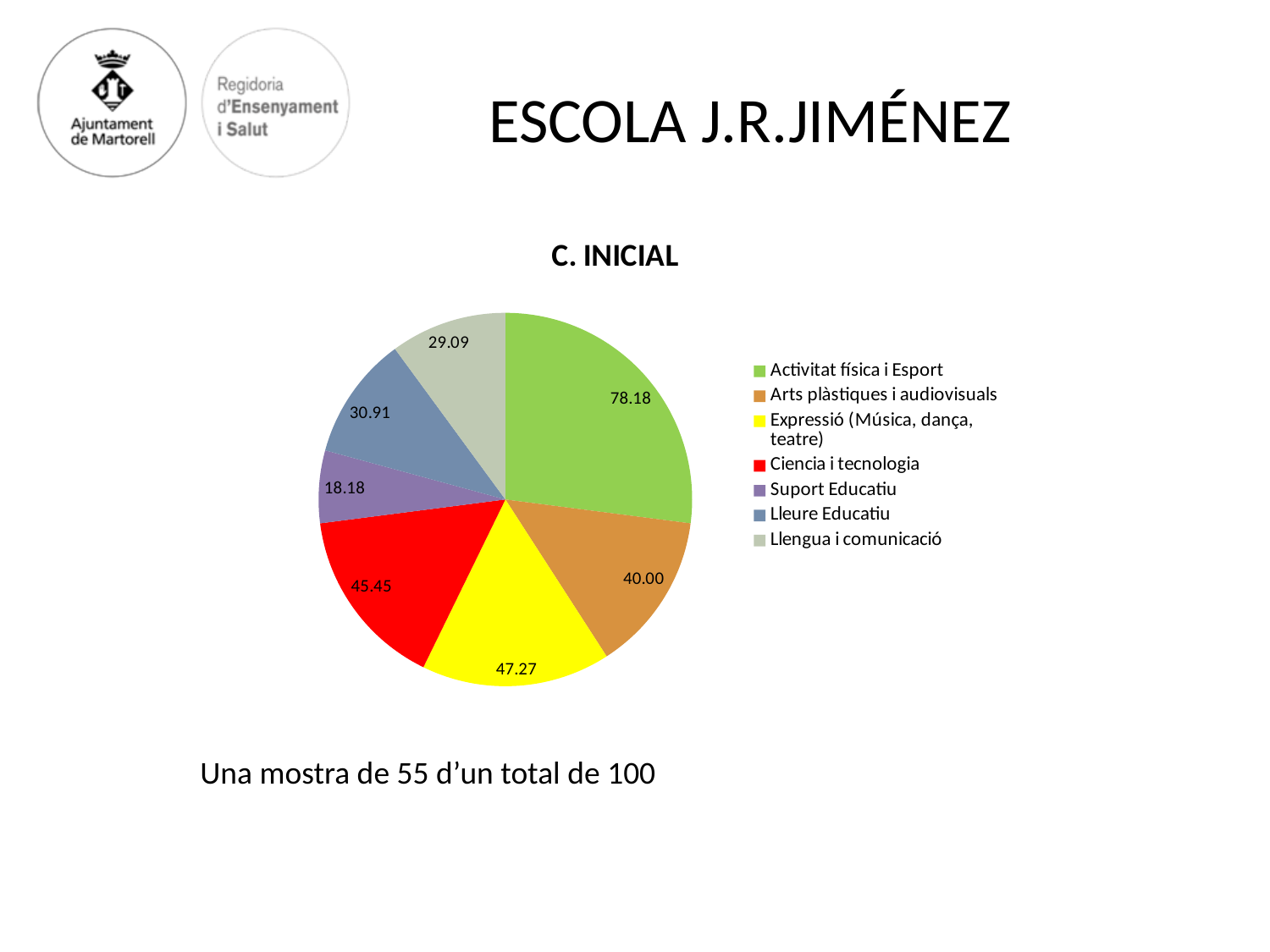
Which is larger, the value for Lleure Educatiu or the value for Llengua i comunicació? Lleure Educatiu What is the value for Suport Educatiu? 18.18 Which category has the lowest value? Suport Educatiu What is the difference between the values for Activitat física i Esport and Ciencia i tecnologia? 32.73 What is the value for Arts plàstiques i audiovisuals? 40.00 Which category has the highest value? Activitat física i Esport What is the value for Activitat física i Esport? 78.18 What type of chart is shown on the slide? pie chart What is the title of the chart? C. INICIAL How many slices does the pie chart have? 7 Which colour represents Ciencia i tecnologia in the pie chart? red What is the value for Expressió (Música, dança, teatre)? 47.27